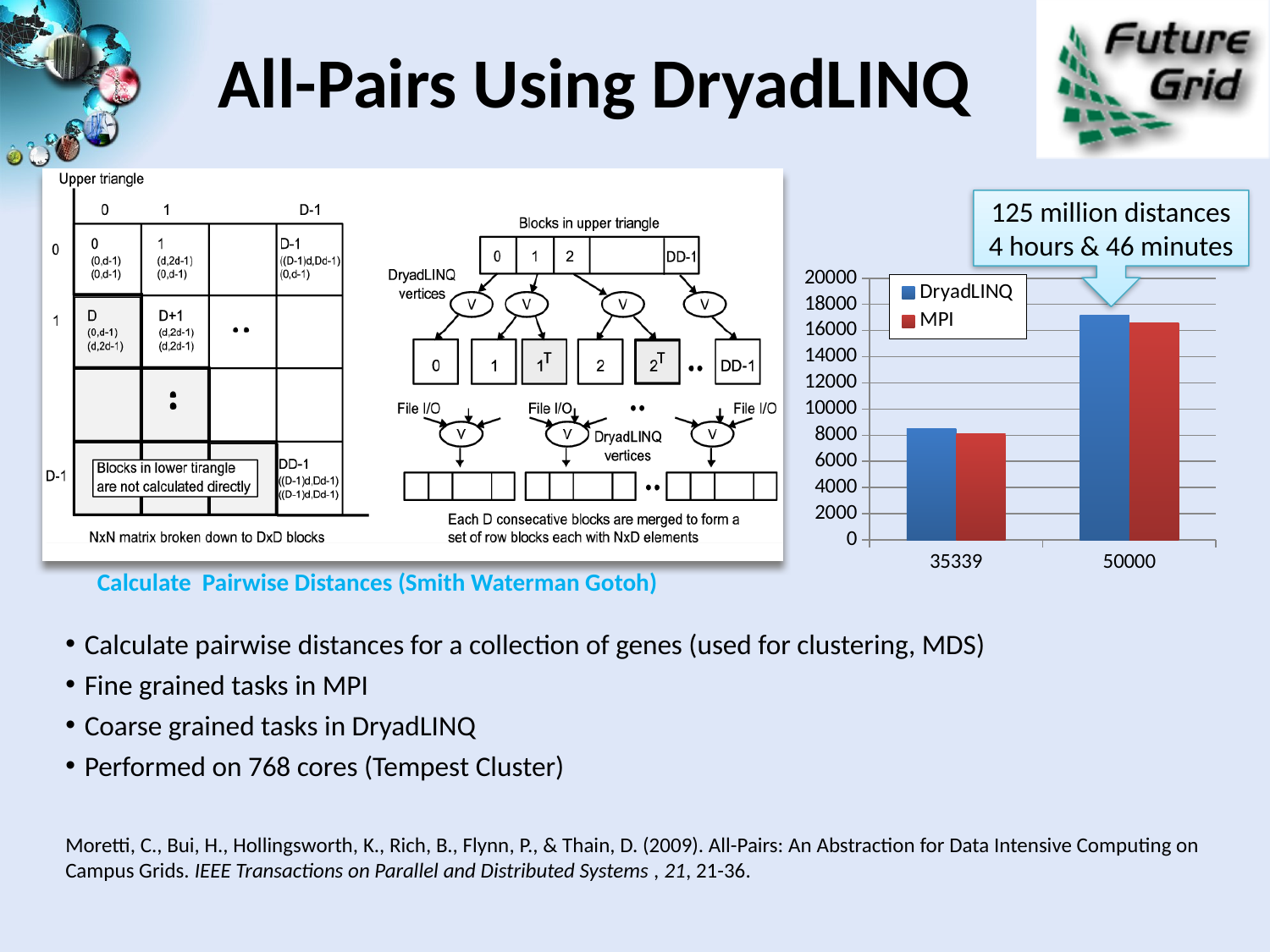
What are the two series named in the bar chart legend? DryadLINQ and MPI How many series does the legend of the bar chart list? 2 What colour are the DryadLINQ bars in the chart? blue Is the DryadLINQ value for 50000 greater or less than 16000? greater What kind of chart is shown on the right of the slide? bar chart Which category on the x axis has the shortest bars in the bar chart? 35339 Is the MPI value for 50000 greater or less than 18000? less Which category on the x axis has the tallest bars in the bar chart? 50000 Is the DryadLINQ value for 35339 greater or less than 8000? greater How many categories are shown on the x axis of the bar chart? 2 Do the bar values rise or fall from 35339 to 50000 along the x axis? rise